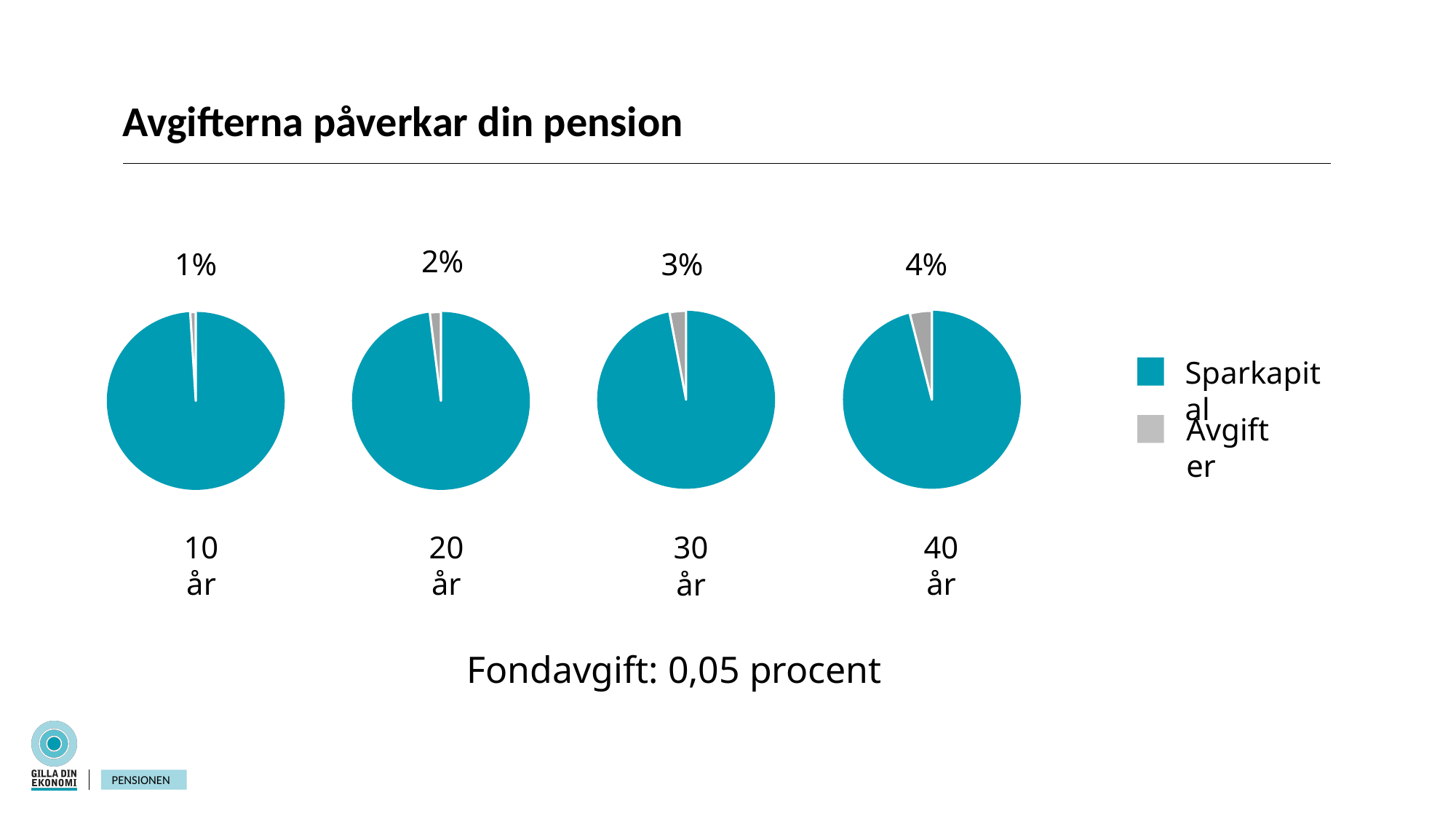
What kind of charts are shown on the slide? Pie charts How many pie charts are on the slide? 4 Which pie chart has the smallest Avgifter slice? 10 år Which pie chart has the largest Avgifter slice? 40 år Does the Avgifter share rise or fall as the number of years increases from 10 år to 40 år? Rise In the pie chart labelled 30 år, what percentage is shown above the chart? 3% How many entries does the legend list? 2 What are the two legend entries on the slide? Sparkapital and Avgifter What is the difference between the percentage shown for 40 år and the percentage shown for 10 år? 3% In the pie chart labelled 40 år, what share of the pie is Avgifter? 4% In the pie chart labelled 20 år, what percentage is shown above the chart? 2% In the pie chart labelled 10 år, what percentage is shown above the chart? 1%